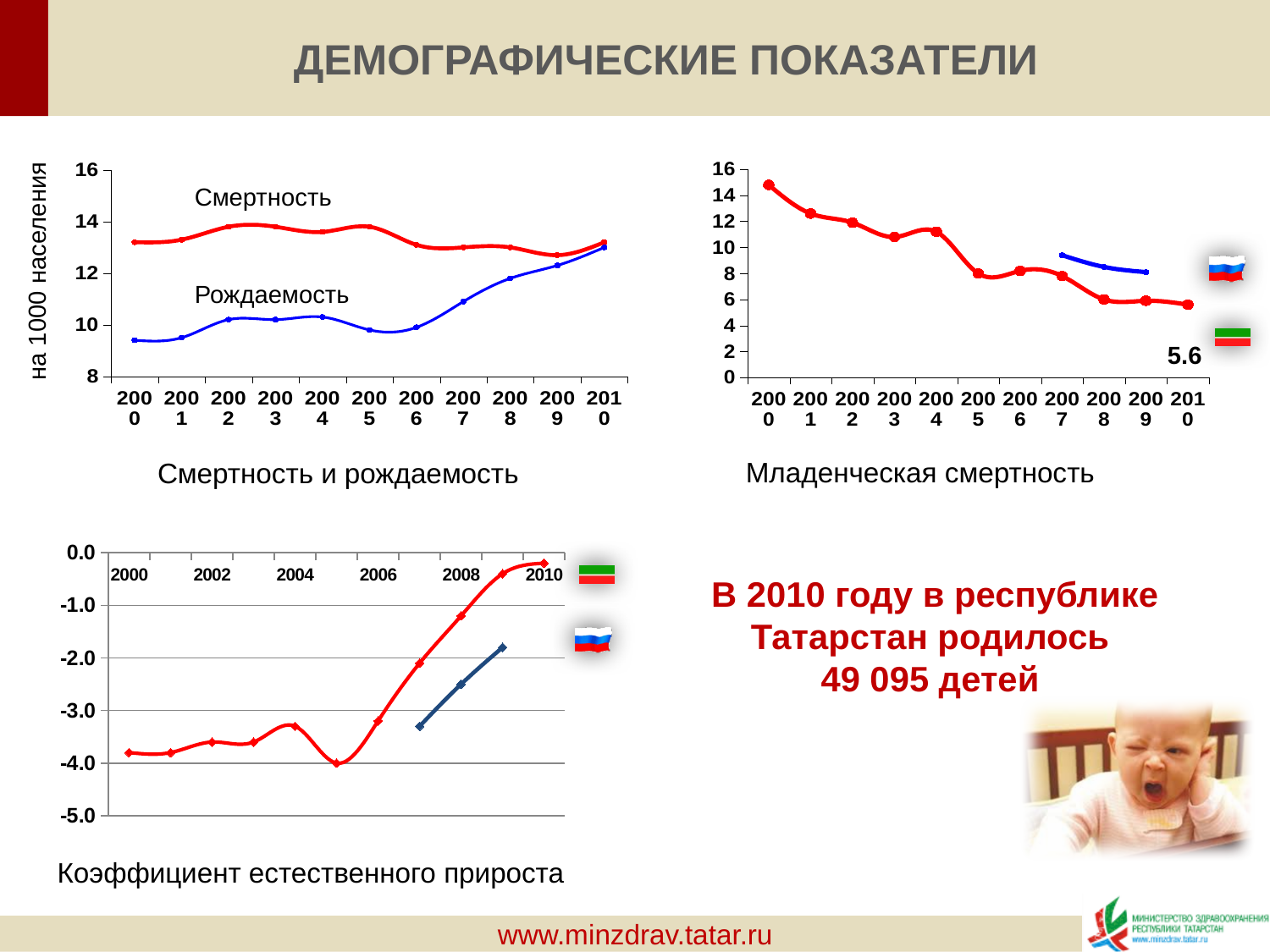
In the 'Смертность и рождаемость' chart, how many years are shown on the x axis? 11 In the 'Коэффициент естественного прироста' chart, is the value for 2010 greater or less than -1.0? greater In the 'Смертность и рождаемость' chart, does Рождаемость rise or fall between 2006 and 2010? rise In the 'Смертность и рождаемость' chart, which two series are labelled? Смертность and Рождаемость In the 'Смертность и рождаемость' chart, is the value for Смертность in 2000 greater or less than 12? greater In the 'Смертность и рождаемость' chart, which series has the higher value in 2000, Смертность or Рождаемость? Смертность In the 'Смертность и рождаемость' chart, is the value for Рождаемость in 2000 greater or less than 10? less In the 'Младенческая смертность' chart, which year has the highest value on the red line? 2000 In the 'Коэффициент естественного прироста' chart, which year has the lowest value on the red line? 2005 In the 'Младенческая смертность' chart, what is the value labelled for 2010? 5.6 What kind of chart is the 'Смертность и рождаемость' chart? line chart